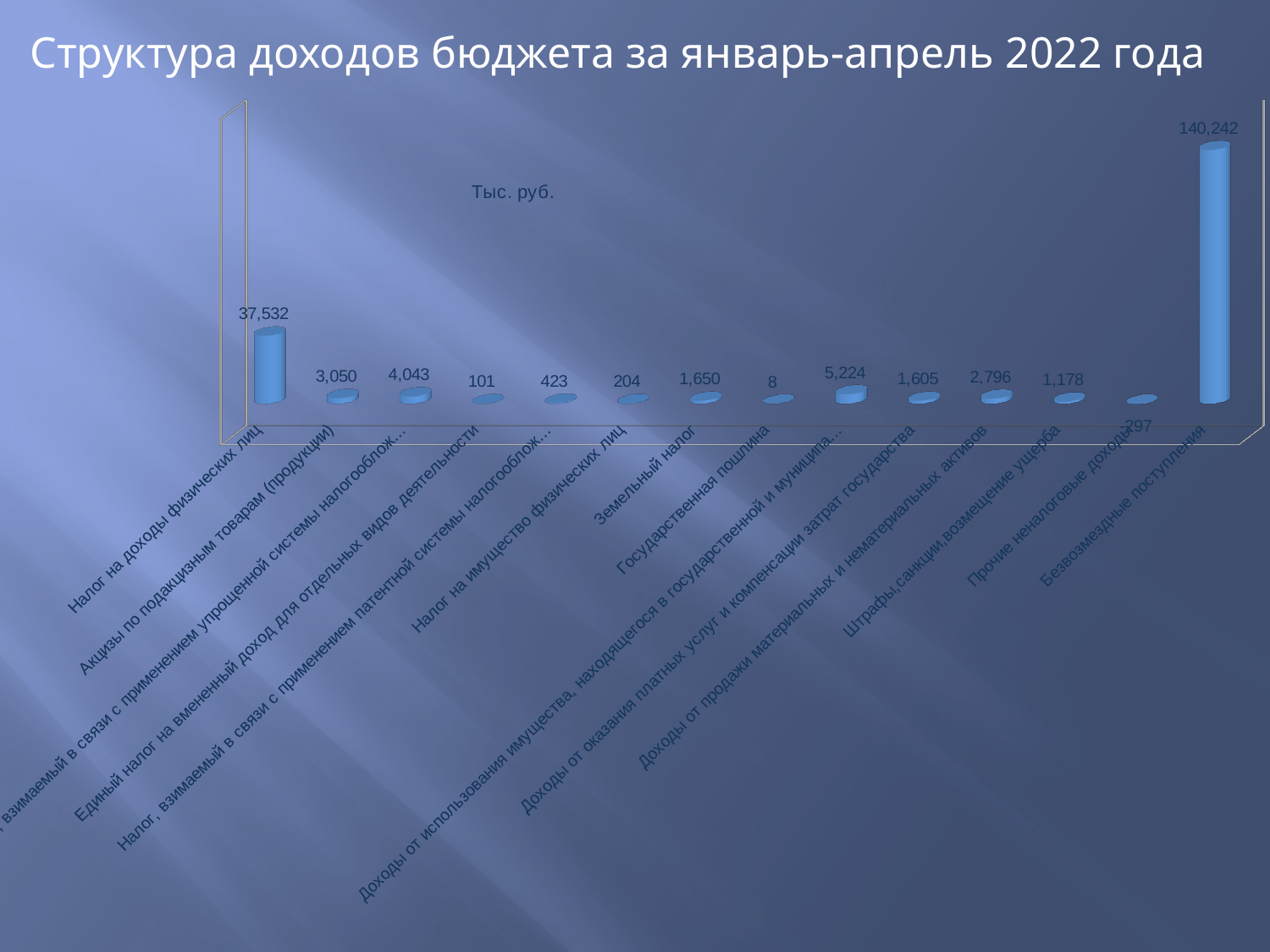
What is the value for Земельный налог? 1,650 What is the difference between the values for Безвозмездные поступления and Налог на доходы физических лиц? 102,710 What kind of chart is shown on the slide? Bar chart Which category has the highest value? Безвозмездные поступления What is the value for Безвозмездные поступления? 140,242 What is the value for Налог на доходы физических лиц? 37,532 What is the value for Государственная пошлина? 8 Which is larger: the value for Акцизы по подакцизным товарам (продукции) or the value for Штрафы,санкции,возмещение ущерба? Акцизы по подакцизным товарам (продукции) What is the difference between the values for Земельный налог and Налог на имущество физических лиц? 1,446 What unit is indicated on the chart? Тыс. руб. What is the value for Доходы от продажи материальных и нематериальных активов? 2,796 How many categories are shown on the chart? 14